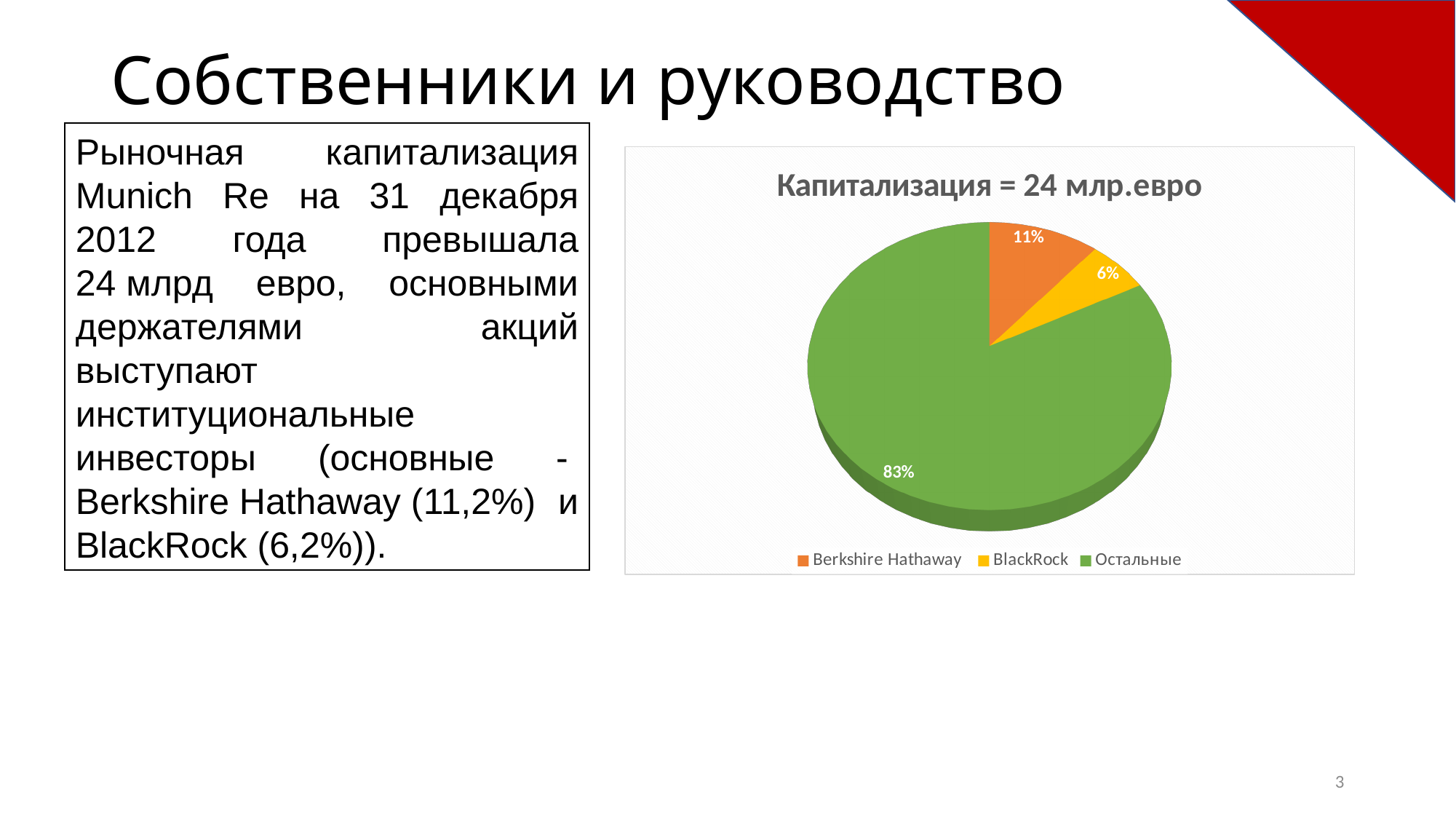
Which is larger, the Berkshire Hathaway slice or the BlackRock slice? Berkshire Hathaway What share of the pie does Berkshire Hathaway hold? 11% What colour is the Остальные slice? green What is the difference in percentage points between the Berkshire Hathaway slice and the BlackRock slice? 5% Which slice of the pie is the largest? Остальные What kind of chart is shown on the slide? pie chart How many slices does the pie chart have? 3 Which slice of the pie is the smallest? BlackRock What share of the pie does BlackRock hold? 6% How many entries does the legend list? 3 What is the title of the chart? Капитализация = 24 млр.евро What share of the pie does Остальные hold? 83%